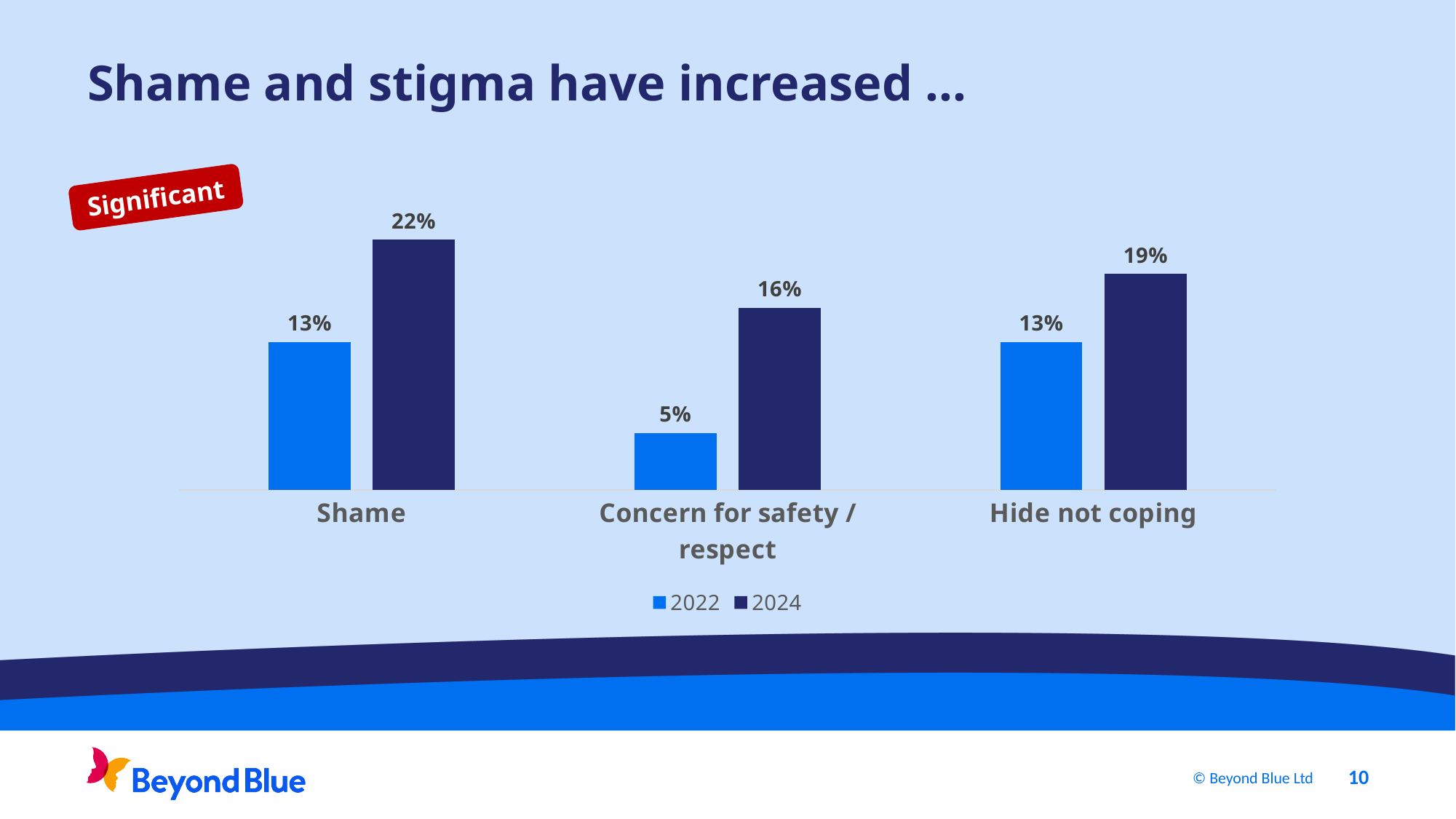
What is the difference between the 2024 and 2022 values for Concern for safety / respect? 11% How many categories are shown on the x axis? 3 Which category has the highest 2024 value? Shame Which category has the lowest 2022 value? Concern for safety / respect What is the 2024 value for Shame? 22% Which is larger for Hide not coping, the 2022 value or the 2024 value? 2024 What is the 2024 value for Hide not coping? 19% What is the 2022 value for Hide not coping? 13% What is the 2022 value for Concern for safety / respect? 5% What kind of chart is shown on the slide? Bar chart What is the difference between the 2024 and 2022 values for Shame? 9% How many series does the legend list? 2